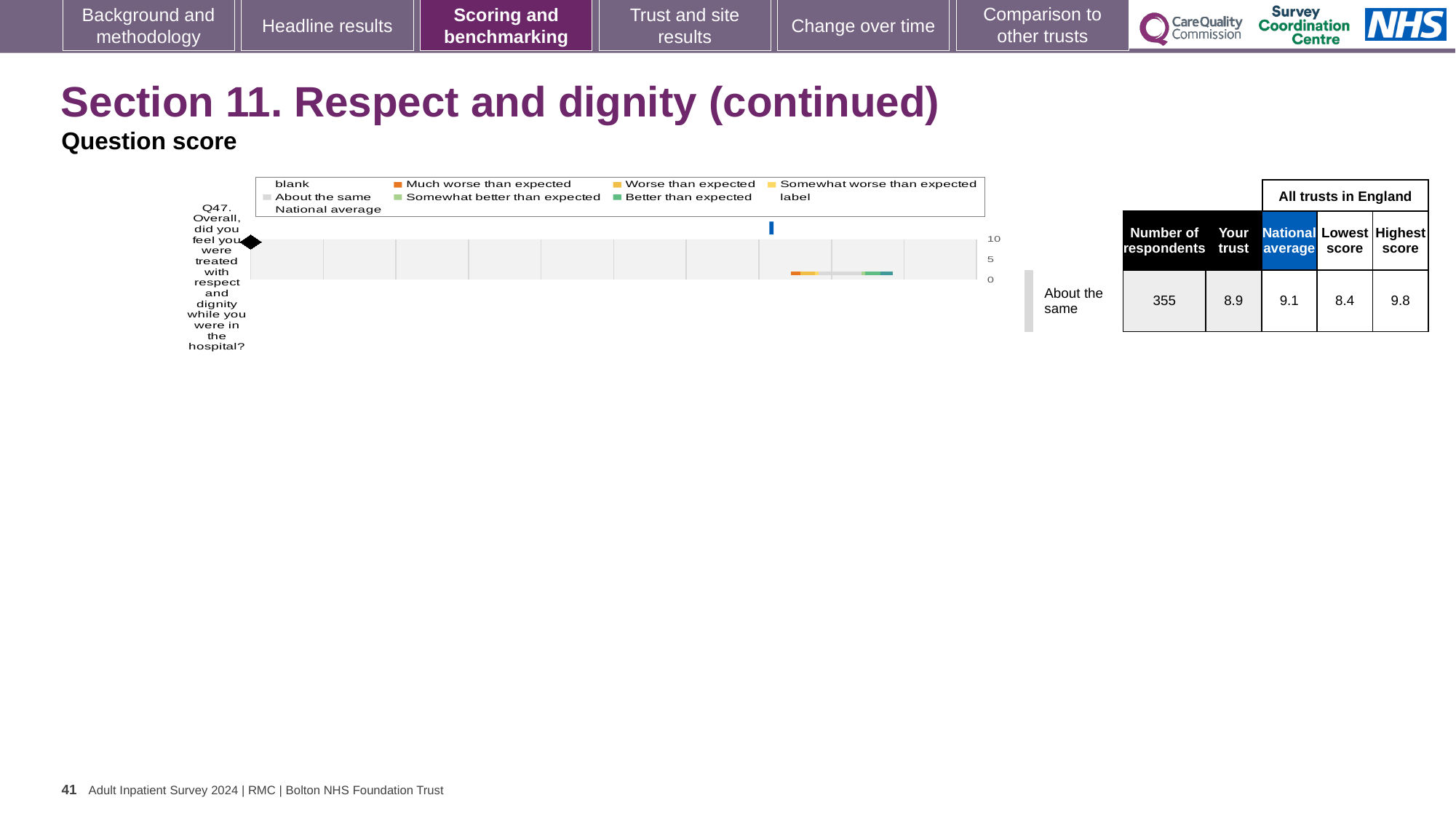
Which benchmarking category is the trust's Q47 score placed in? About the same What is the lowest score among all trusts in England for Q47? 8.4 What is the highest tick value shown on the chart's score axis? 10 How many questions are plotted on the chart? 1 What is the highest score among all trusts in England for Q47? 9.8 Which question number is shown on the chart? Q47 What is the difference between the national average and the trust's score for Q47? 0.2 What is the 'Your trust' score for Q47? 8.9 What is the difference between the highest and lowest scores among all trusts in England for Q47? 1.4 How many respondents answered Q47? 355 What is the national average score for Q47? 9.1 Is the trust's score for Q47 higher or lower than the national average? lower